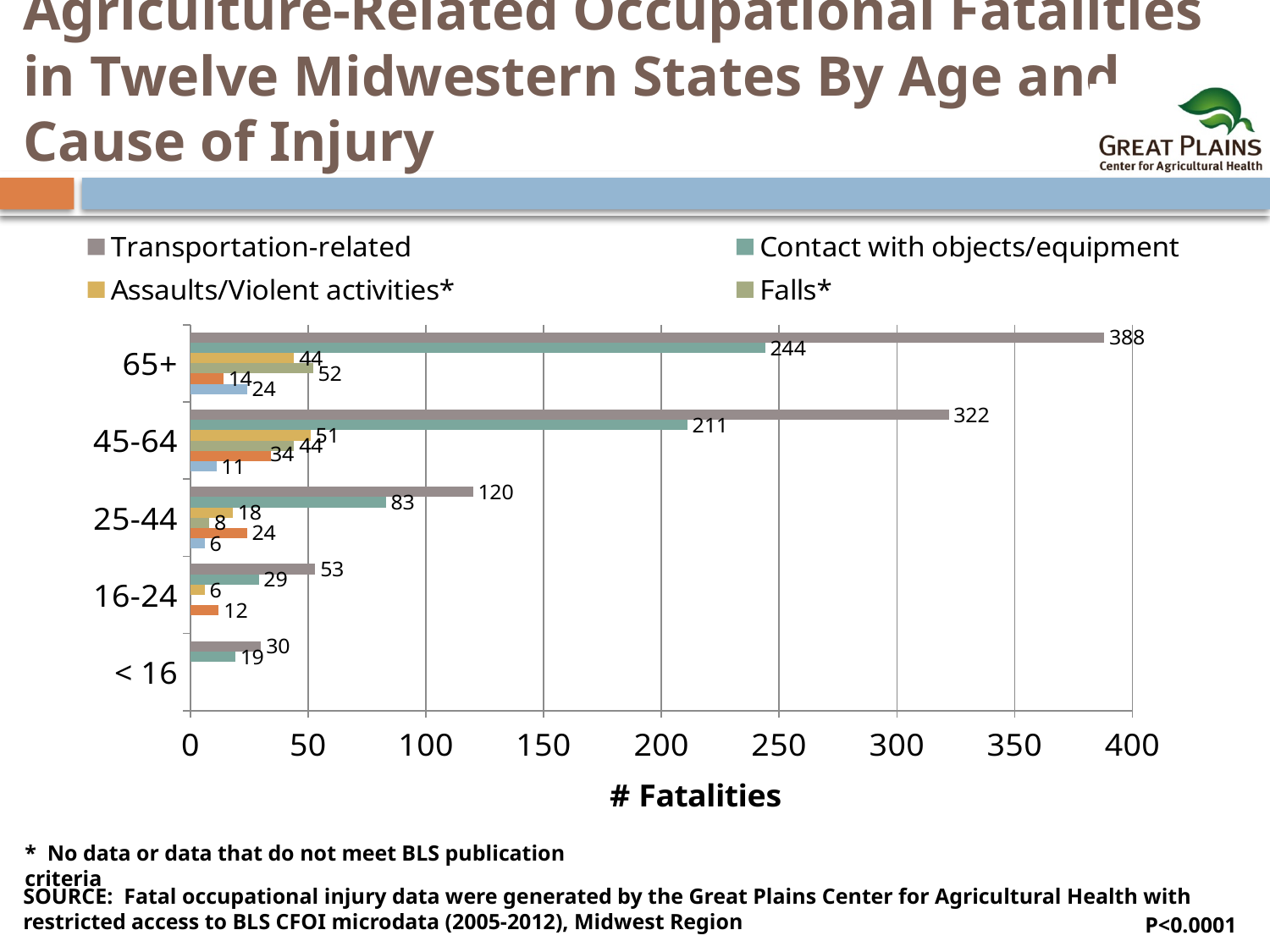
What is the difference between transportation-related fatalities for the 65+ and 45-64 age groups? 66 Which age group has the highest number of transportation-related fatalities? 65+ Which is larger for the 45-64 age group: Assaults/Violent activities or Falls? Assaults/Violent activities What is the label of the x axis? # Fatalities Which age group has the lowest number of transportation-related fatalities? < 16 What is the number of fatalities from contact with objects/equipment for the 45-64 age group? 211 How many series does the legend list? 4 What type of chart is shown on the slide? bar chart How many age groups are shown on the chart? 5 What is the number of transportation-related fatalities for the 65+ age group? 388 What is the number of fatalities from contact with objects/equipment for the < 16 age group? 19 What is the number of transportation-related fatalities for the 25-44 age group? 120